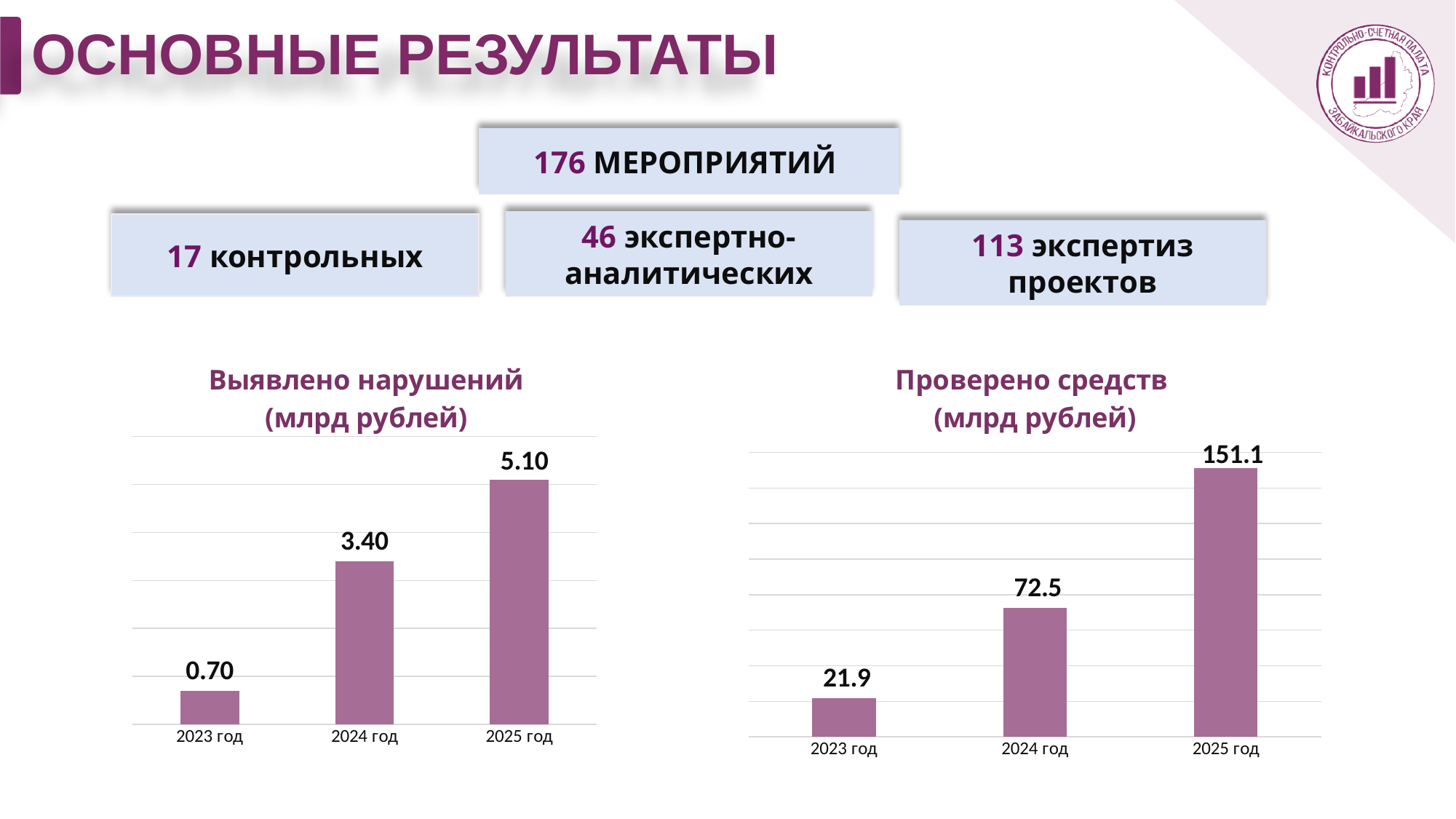
How many bars are in the 'Выявлено нарушений (млрд рублей)' chart? 3 In the 'Проверено средств (млрд рублей)' chart, which year has the lowest value? 2023 год In the 'Выявлено нарушений (млрд рублей)' chart, what is the value for 2024 год? 3.40 In the 'Проверено средств (млрд рублей)' chart, what is the difference between the values for 2024 год and 2023 год? 50.6 In the 'Выявлено нарушений (млрд рублей)' chart, what is the difference between the values for 2025 год and 2024 год? 1.70 In the 'Проверено средств (млрд рублей)' chart, what is the value for 2023 год? 21.9 In the 'Проверено средств (млрд рублей)' chart, which is larger: the value for 2024 год or 2025 год? 2025 год In the 'Выявлено нарушений (млрд рублей)' chart, what is the value for 2023 год? 0.70 In the 'Выявлено нарушений (млрд рублей)' chart, which year has the highest value? 2025 год What kind of chart is the 'Проверено средств (млрд рублей)' chart? bar chart In the 'Проверено средств (млрд рублей)' chart, what is the value for 2025 год? 151.1 In the 'Проверено средств (млрд рублей)' chart, do the values rise or fall from 2023 год to 2025 год? rise